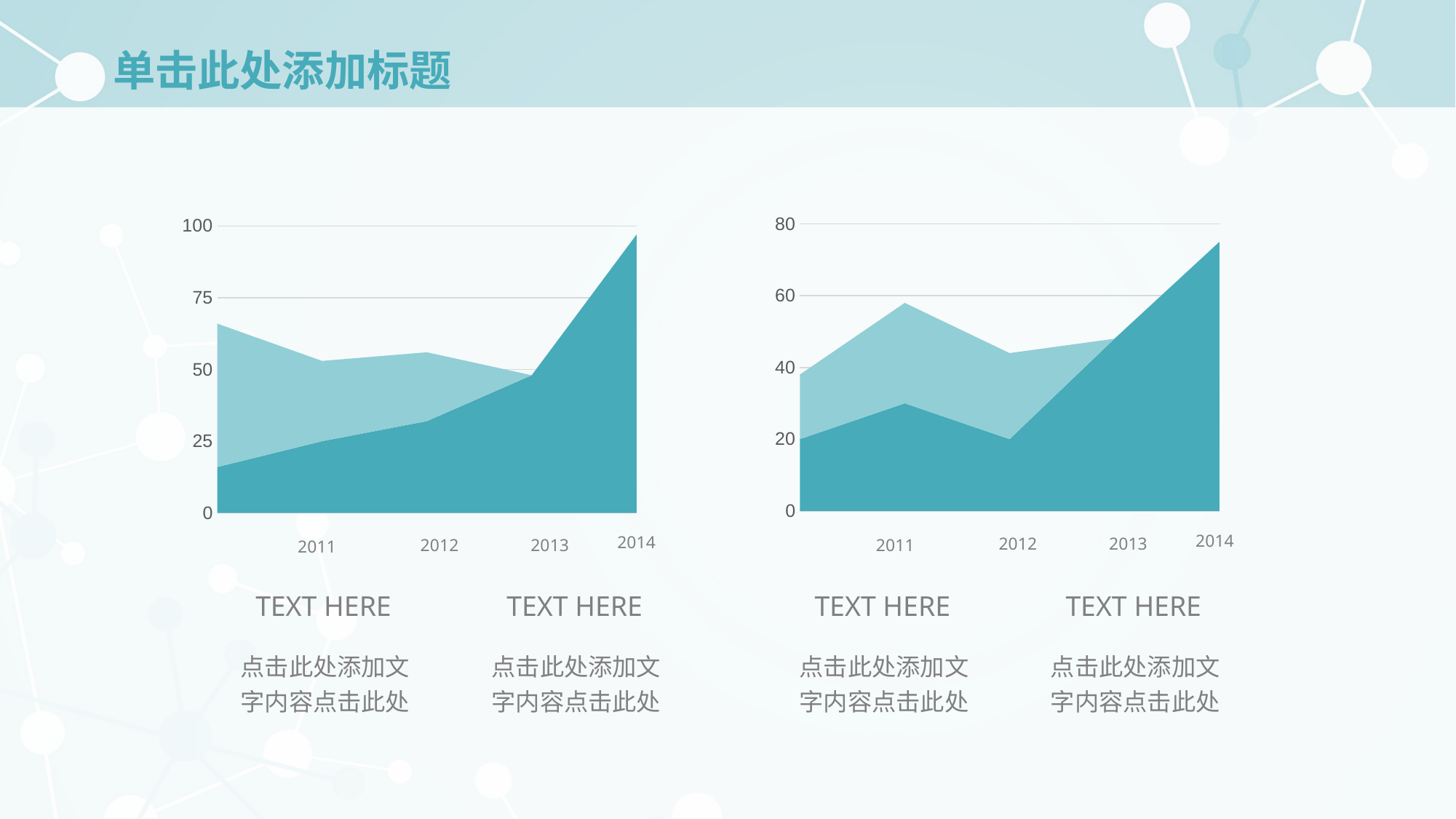
In the chart on the left, does the darker series rise or fall from 2011 to 2014? rise In the chart on the left, is the value of the darker series for 2012 greater or less than 25? greater What kind of chart is the chart on the right of the slide? area chart What kind of chart is the chart on the left of the slide? area chart In the chart on the right, is the value of the darker series for 2011 greater or less than 20? greater In the chart on the right, is the value of the darker series for 2014 greater or less than 60? greater In the chart on the right, which year has the highest value for the lighter series? 2011 In the chart on the left, which year has the highest value for the darker series? 2014 What is the highest value shown on the vertical axis of the chart on the right? 80